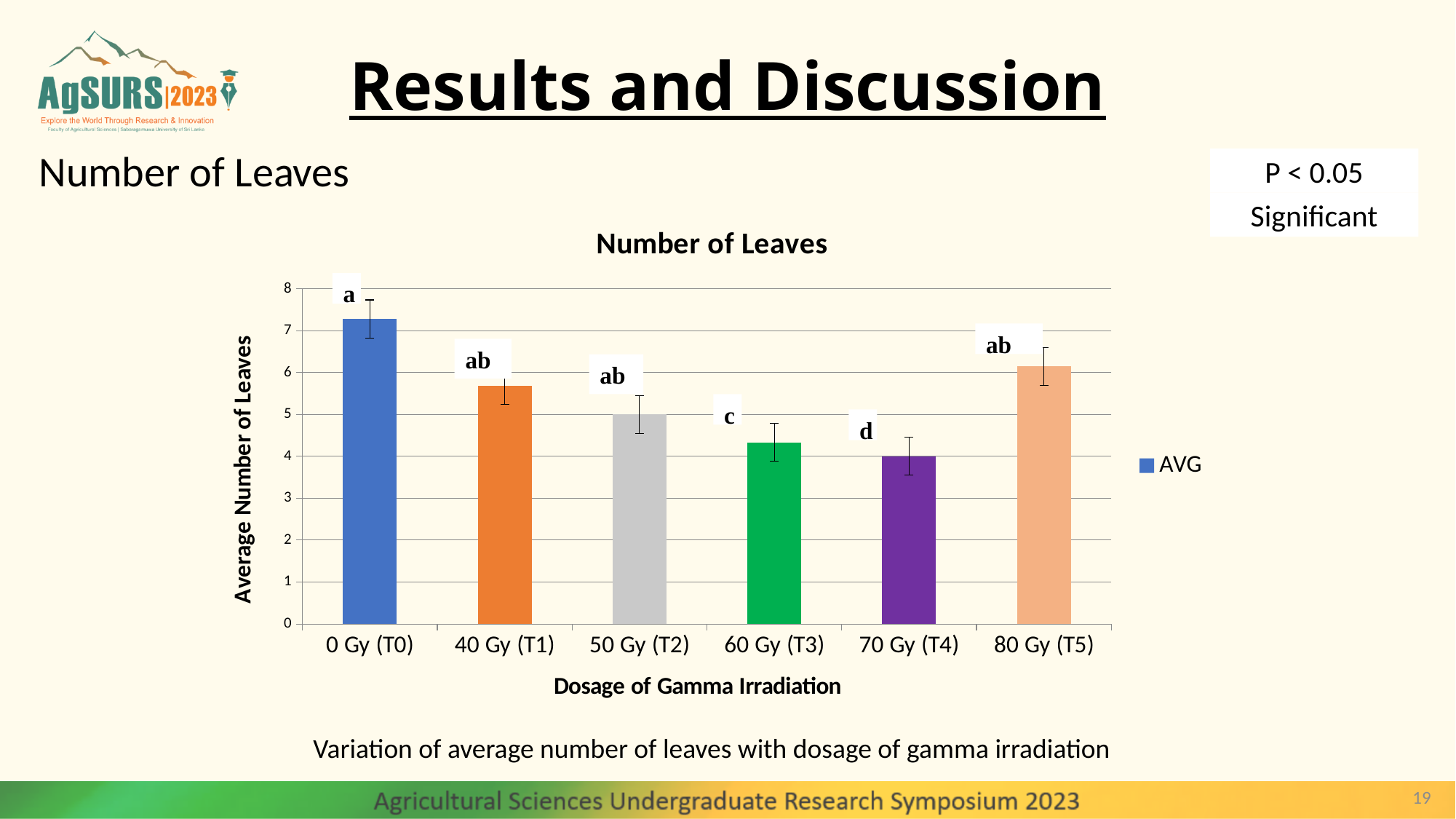
What is the title of the x axis? Dosage of Gamma Irradiation Is the value for 0 Gy (T0) greater or less than 7? greater Which dosage has the highest average number of leaves? 0 Gy (T0) How many dosage categories are plotted on the x axis? 6 Is the value for 40 Gy (T1) greater or less than 5? greater Which has a larger average number of leaves, 40 Gy (T1) or 60 Gy (T3)? 40 Gy (T1) What is the name of the series shown in the legend? AVG Which dosage has the lowest average number of leaves? 70 Gy (T4) Which has a larger average number of leaves, 0 Gy (T0) or 80 Gy (T5)? 0 Gy (T0) Is the value for 60 Gy (T3) greater or less than 5? less What kind of chart is shown on the slide? bar chart How many series does the legend list? 1